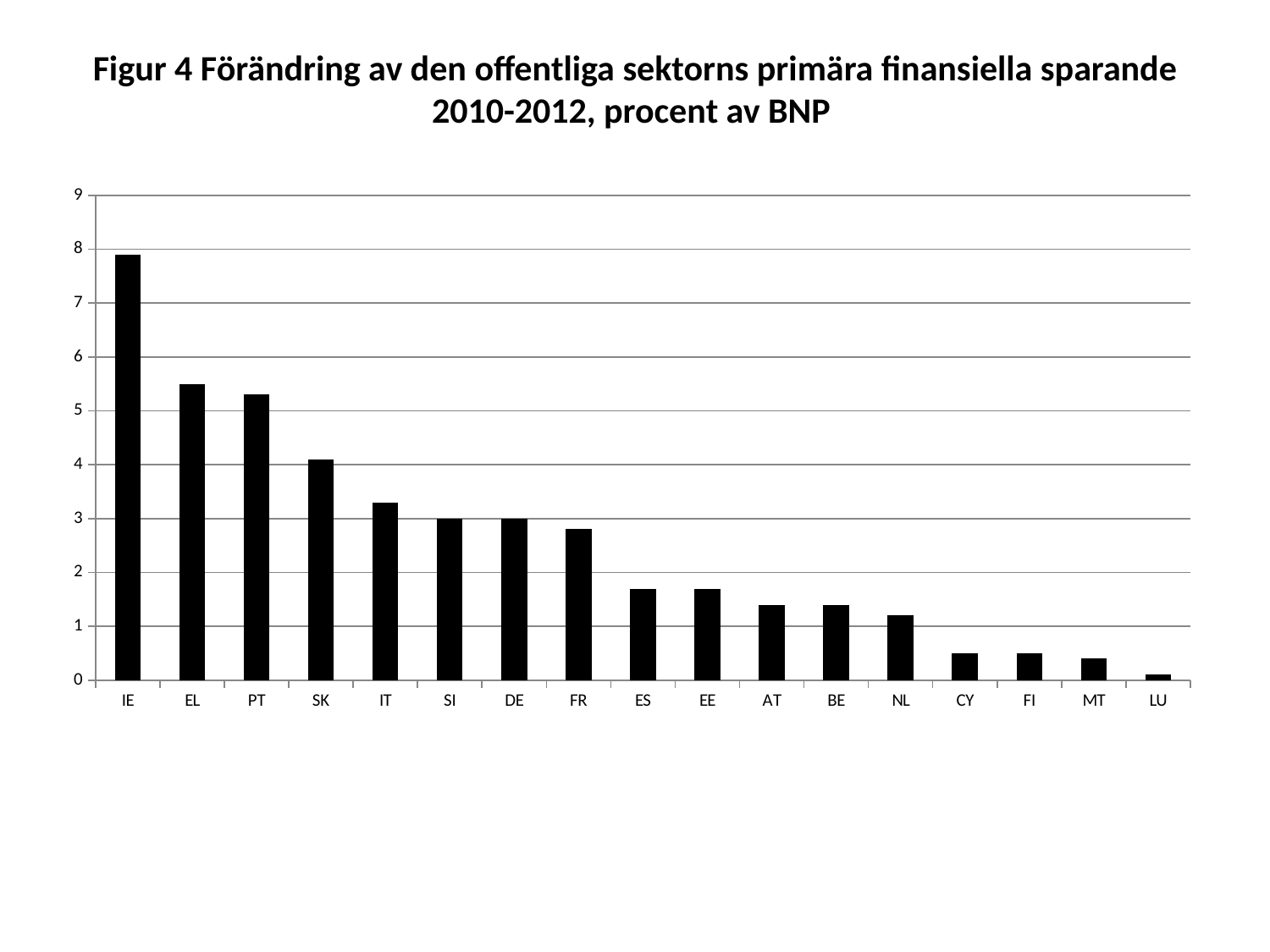
Is the value for CY greater or less than 1? less Which country has the highest value in the chart? IE Which has the larger value, SK or IT? SK What is the title of the chart? Figur 4 Förändring av den offentliga sektorns primära finansiella sparande 2010-2012, procent av BNP What kind of chart is shown on the slide? bar chart Do the values rise or fall from left to right along the x axis? fall Is the value for IE greater or less than 7? greater Which has the larger value, IE or EL? IE Is the value for FR greater or less than 3? less How many countries are shown on the x axis? 17 Which country has the lowest value in the chart? LU